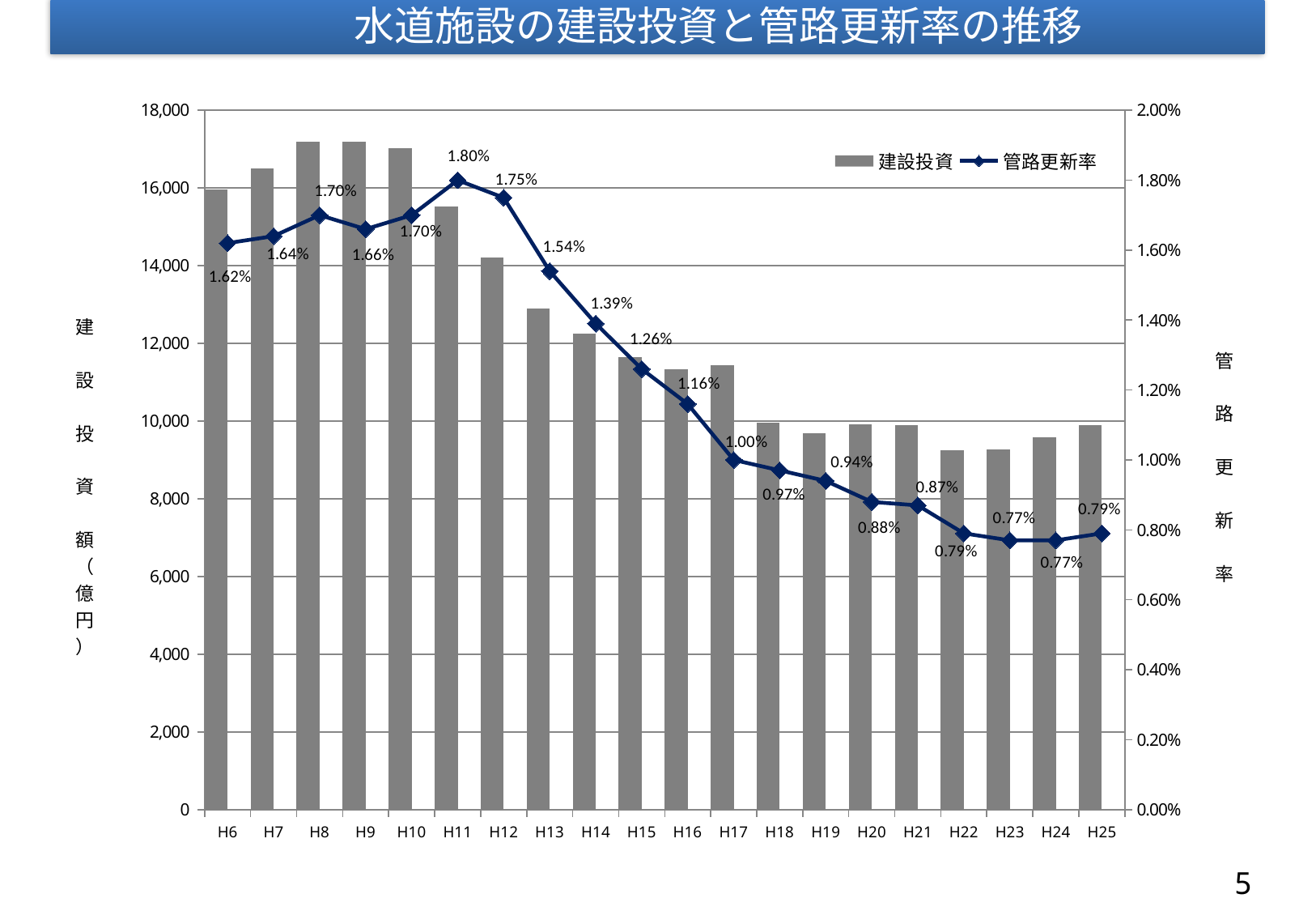
What is the 管路更新率 value for H11? 1.80% What is the 管路更新率 value for H25? 0.79% Is the 建設投資 value for H22 greater or less than 10,000? less How many series does the legend list? 2 What is the 管路更新率 value for H17? 1.00% How many years are shown on the x axis? 20 What kind of chart is this? Combination bar and line chart Does the 管路更新率 rise or fall from H11 to H25? fall What is the difference between the 管路更新率 for H11 and for H25? 1.01% In which year is the 管路更新率 highest? H11 Which year has the larger 管路更新率, H8 or H9? H8 Is the 建設投資 value for H6 greater or less than 14,000? greater